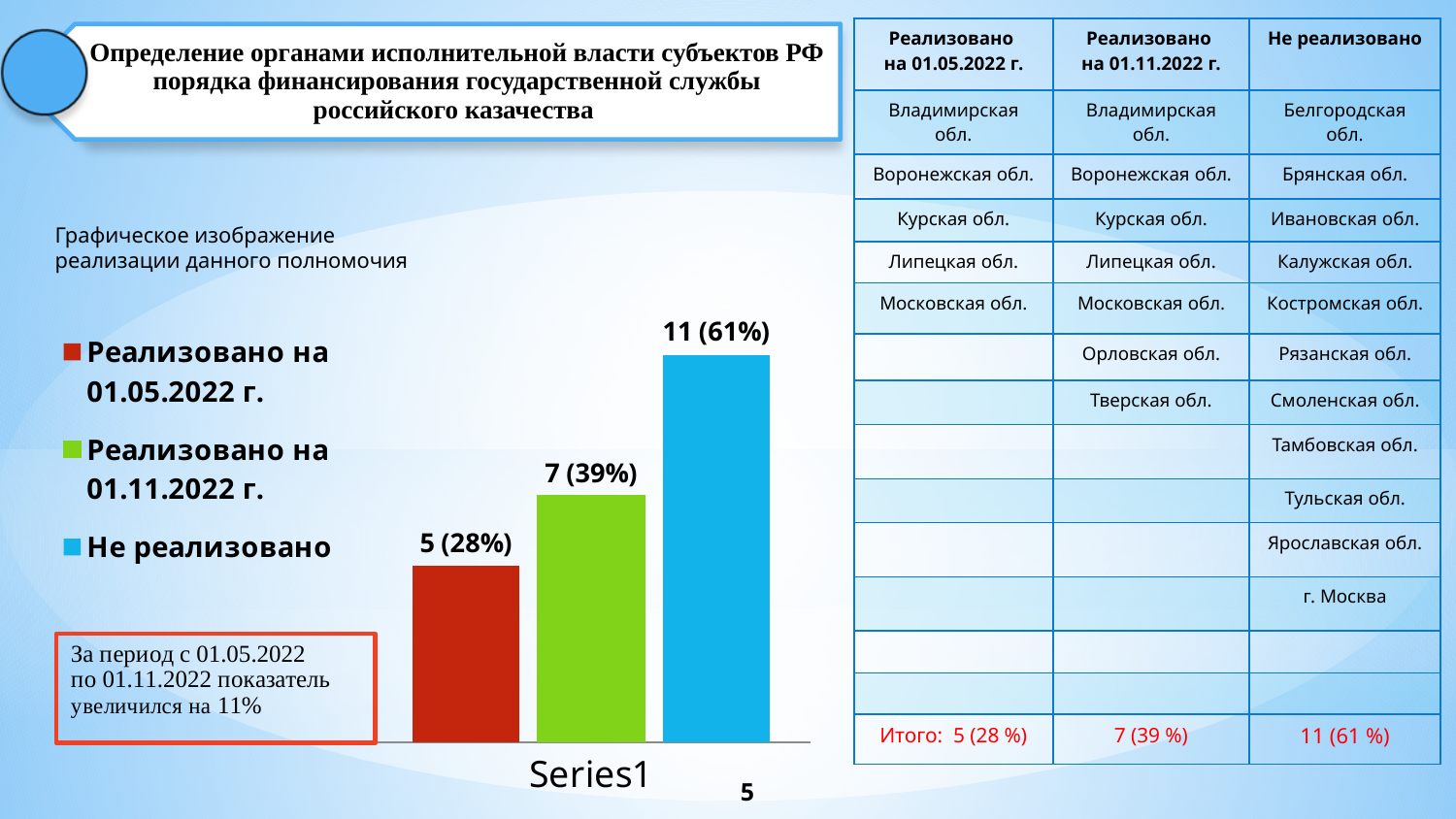
How many bars are plotted in the chart? 3 What is the difference in count between "Реализовано на 01.11.2022 г." and "Реализовано на 01.05.2022 г."? 2 What value is shown on the bar for "Реализовано на 01.05.2022 г."? 5 (28%) Which series has the lowest bar in the chart? Реализовано на 01.05.2022 г. What value is shown on the bar for "Не реализовано"? 11 (61%) What colour is the bar for "Не реализовано"? Blue What is the difference in count between "Не реализовано" and "Реализовано на 01.11.2022 г."? 4 Which is larger: the bar for "Реализовано на 01.11.2022 г." or the bar for "Не реализовано"? Не реализовано What kind of chart is shown on the slide? Bar chart What value is shown on the bar for "Реализовано на 01.11.2022 г."? 7 (39%) Which series has the highest bar in the chart? Не реализовано How many series does the chart legend list? 3